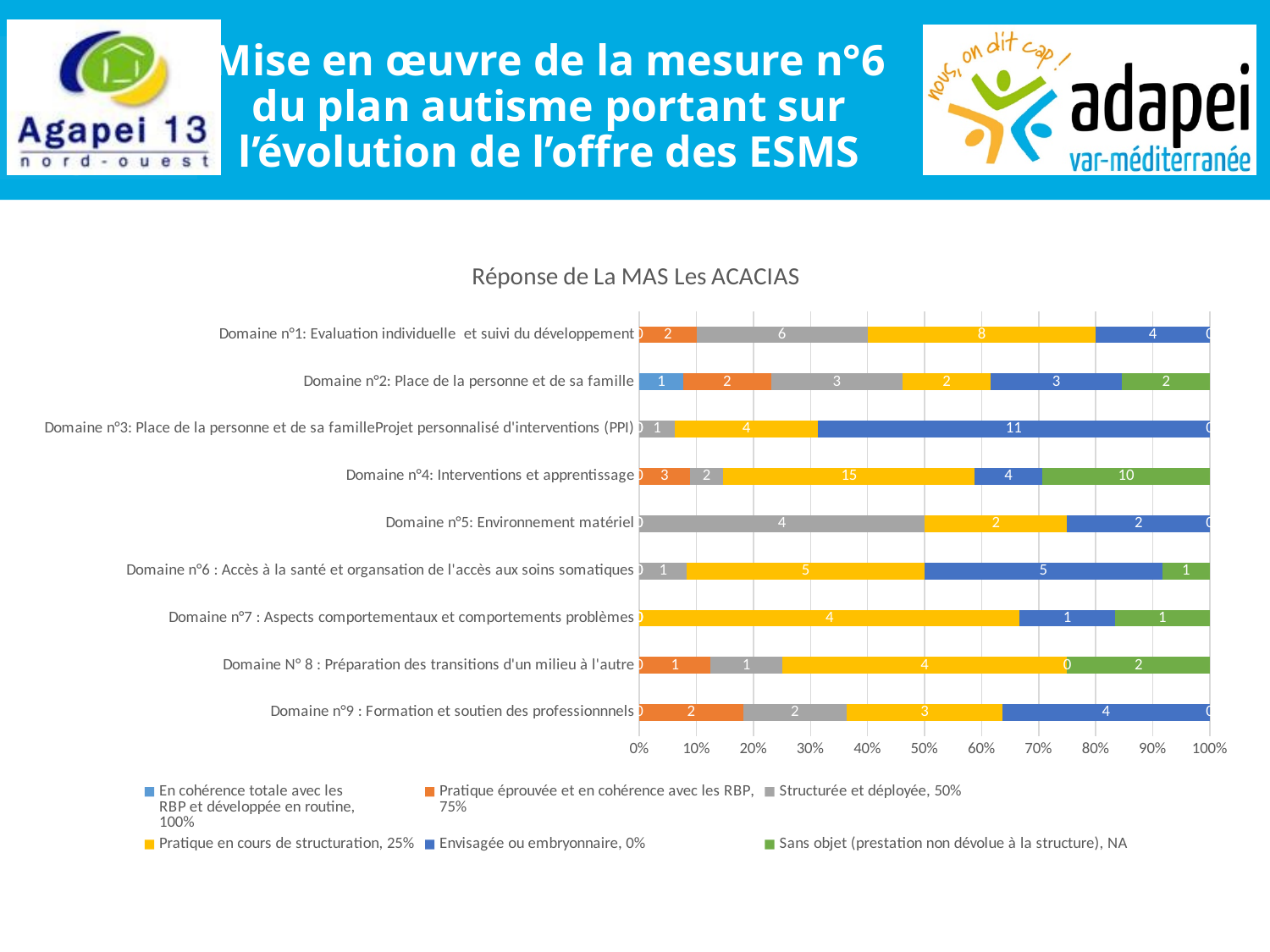
How many domain categories are plotted on the chart? 9 What is the value of the 'Sans objet (prestation non dévolue à la structure), NA' series for Domaine n°4: Interventions et apprentissage? 10 What is the value of the 'Pratique éprouvée et en cohérence avec les RBP, 75%' series for Domaine n°2: Place de la personne et de sa famille? 2 What is the value of the 'Structurée et déployée, 50%' series for Domaine n°1: Evaluation individuelle et suivi du développement? 6 What is the value of the 'Envisagée ou embryonnaire, 0%' series for Domaine n°3: Place de la personne et de sa familleProjet personnalisé d'interventions (PPI)? 11 What kind of chart is shown on the slide? Stacked bar chart What is the value of the 'Pratique en cours de structuration, 25%' series for Domaine n°4: Interventions et apprentissage? 15 Which domain has the highest value for the 'Pratique en cours de structuration, 25%' series? Domaine n°4: Interventions et apprentissage For Domaine n°9 : Formation et soutien des professionnnels, which is larger: the 'Pratique en cours de structuration, 25%' value or the 'Envisagée ou embryonnaire, 0%' value? Envisagée ou embryonnaire, 0% For Domaine n°1: Evaluation individuelle et suivi du développement, what is the difference between the 'Pratique en cours de structuration, 25%' value and the 'Envisagée ou embryonnaire, 0%' value? 4 What is the title of the chart? Réponse de La MAS Les ACACIAS How many series does the legend list? 6